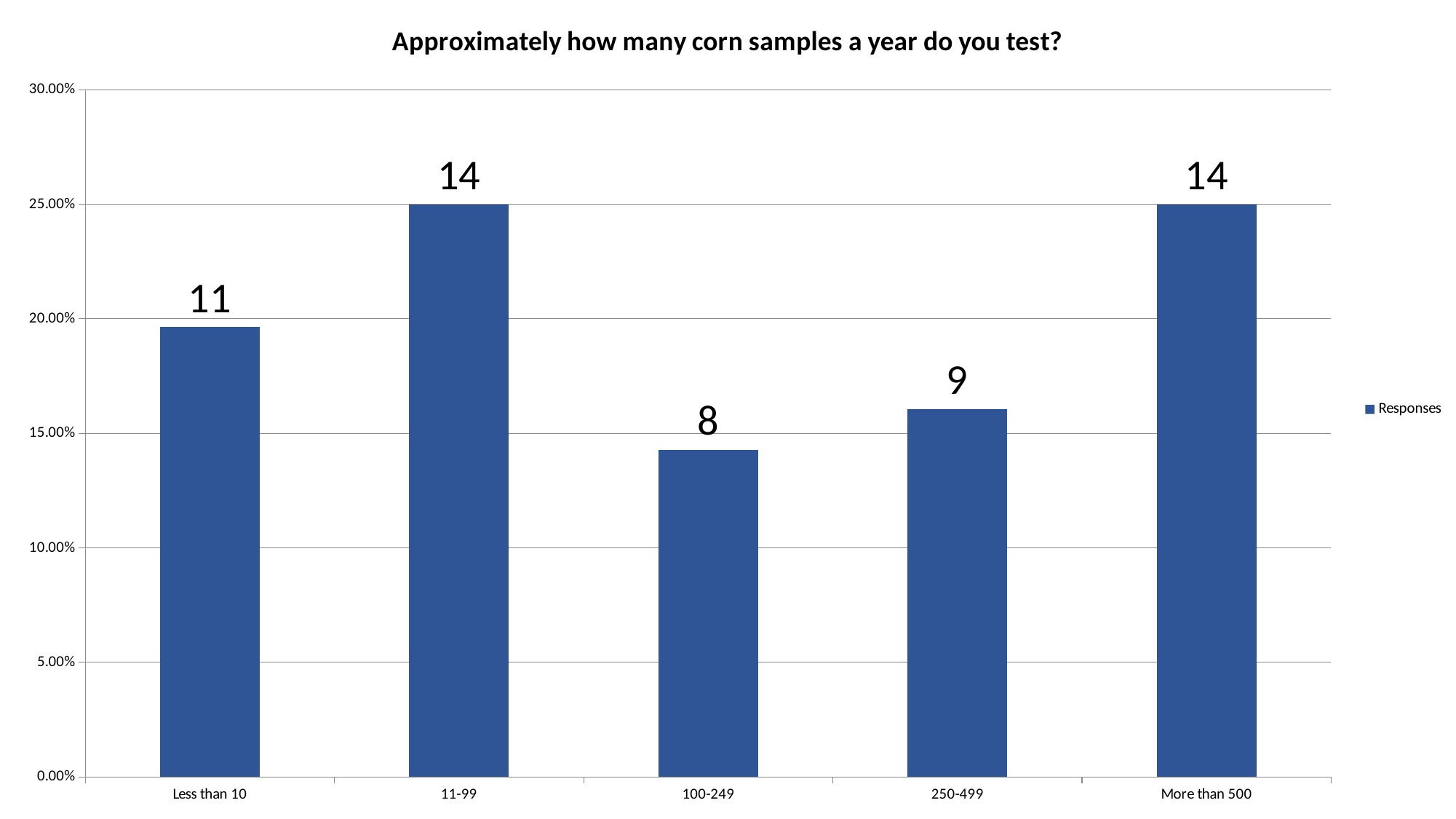
What is the data label shown for the 100-249 category? 8 What is the difference between the data labels for Less than 10 and 250-499? 2 What is the difference between the data labels for 11-99 and 100-249? 6 How many categories are shown on the x axis? 5 Which has more responses, Less than 10 or 250-499? Less than 10 How many series does the legend list? 1 What is the data label shown for the 11-99 category? 14 What is the data label shown for the Less than 10 category? 11 Is the bar for 250-499 greater or less than 20.00% on the axis? less Which category has the lowest number of responses? 100-249 What is the data label shown for the 250-499 category? 9 What kind of chart is shown on the slide? bar chart